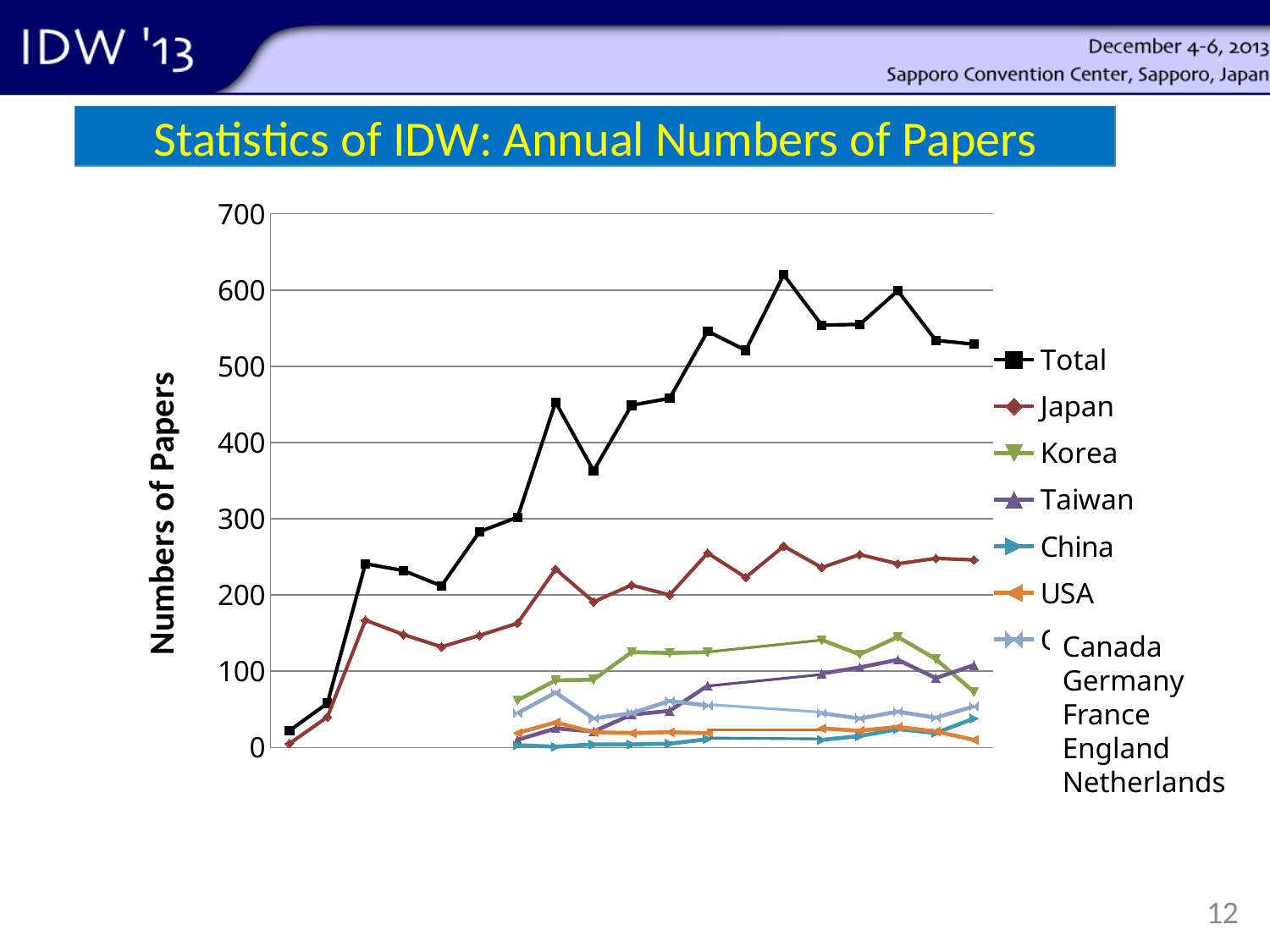
What is the label of the vertical axis? Numbers of Papers Is the highest value of the Total series greater or less than 600? greater Which series has higher values, Japan or Korea? Japan Among the individual countries plotted, which one has the highest number of papers? Japan Does the Total series generally rise or fall from left to right? rise Which series reaches the highest values on the chart? Total Which series has higher values, Korea or China? Korea Is the highest value of the Korea series greater or less than 100? greater Are the values of the USA series greater or less than 100? less What kind of chart is shown on the slide? line chart